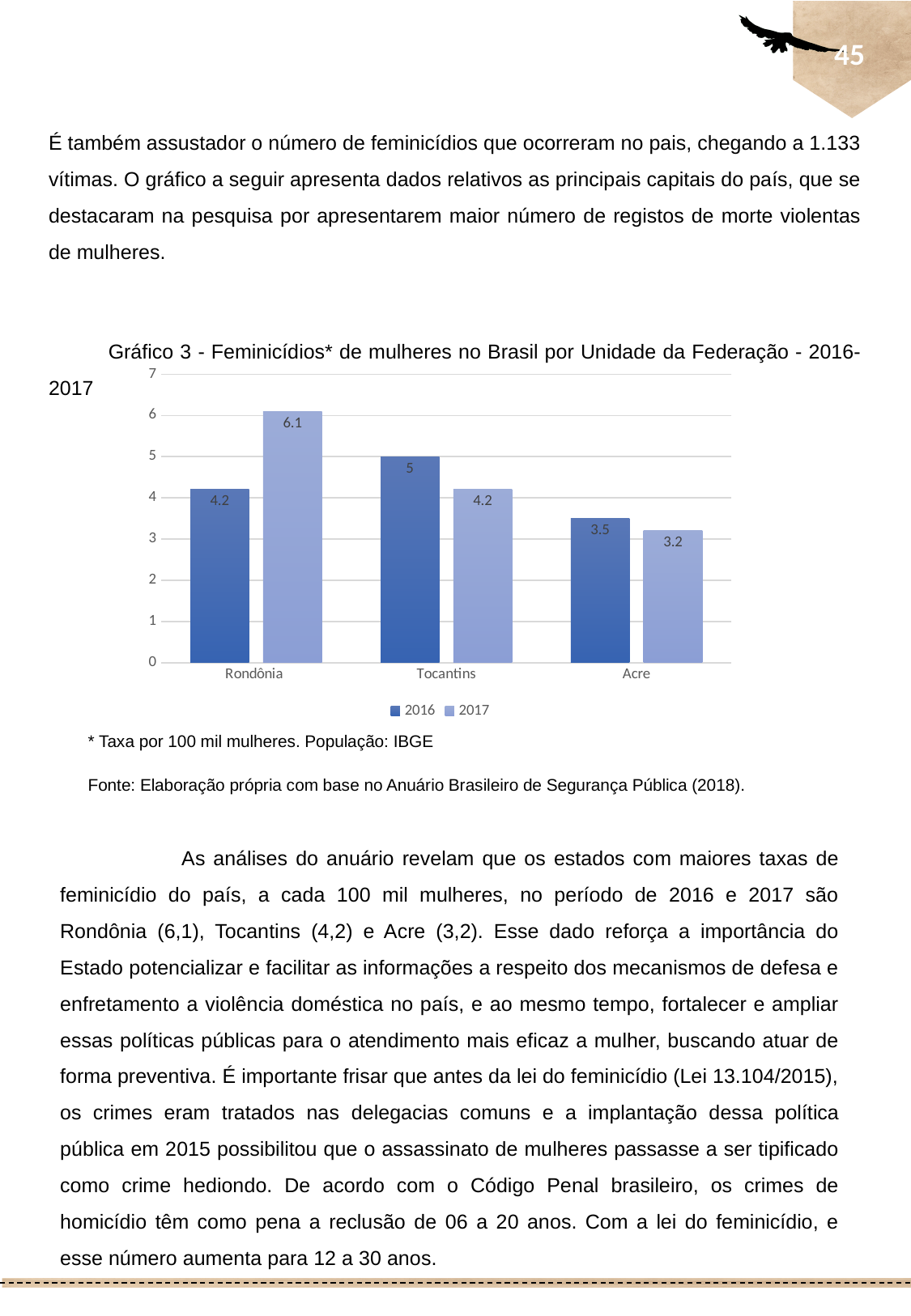
Which is larger for Tocantins, the 2016 value or the 2017 value? 2016 Is the 2016 value for Acre greater or less than 4? less What is the difference between the 2017 and 2016 values for Rondônia? 1.9 Which category has the lowest 2016 value? Acre What is the 2016 value for Rondônia? 4.2 Which category has the highest 2017 value? Rondônia How many categories are shown on the x axis? 3 What is the 2017 value for Rondônia? 6.1 What kind of chart is shown? bar chart How many series does the legend list? 2 What is the 2016 value for Tocantins? 5 What is the 2017 value for Acre? 3.2